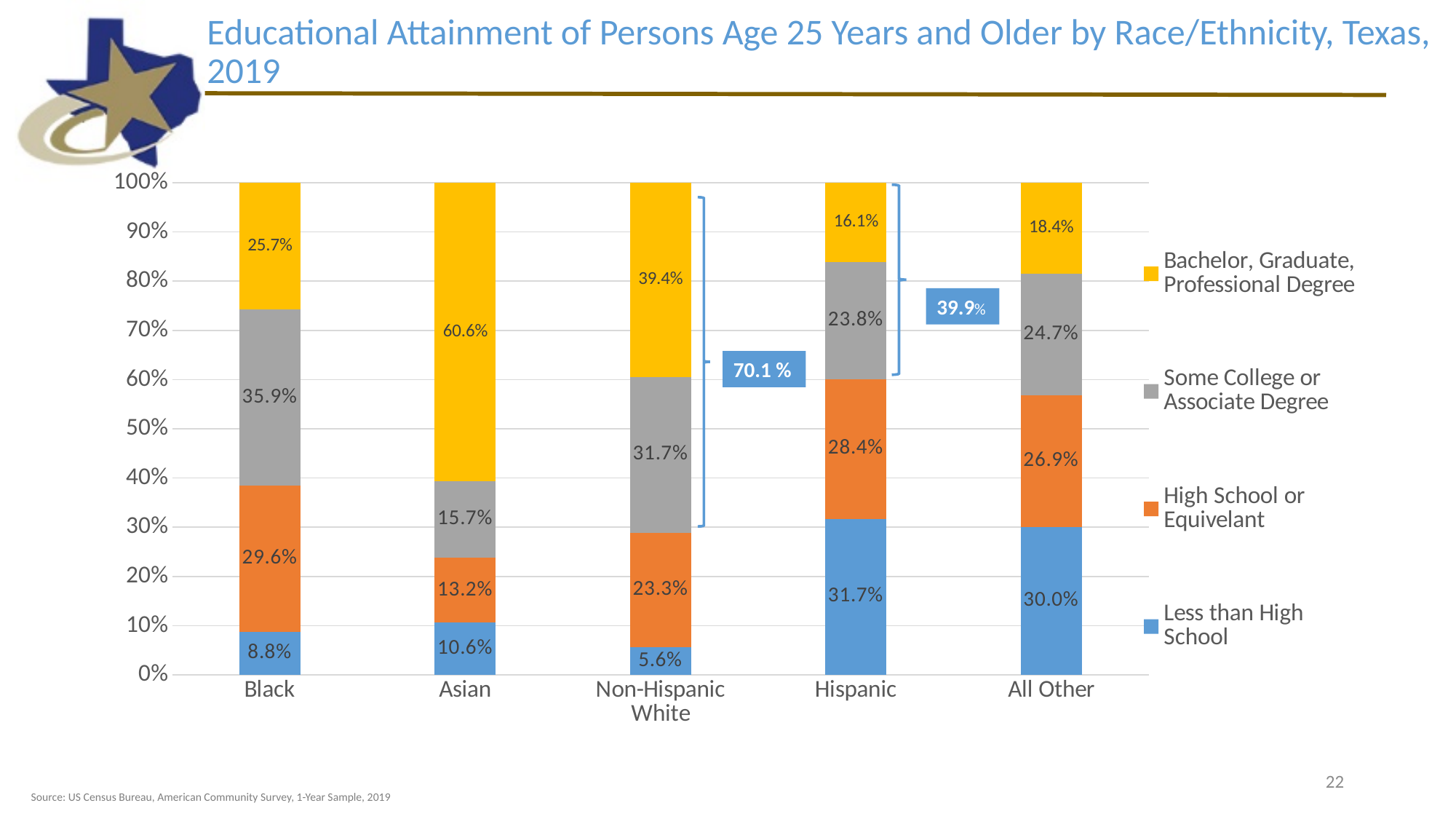
Which is larger: the Some College or Associate Degree share for Black persons or for Asian persons? Black Which colour represents Less than High School in the chart? Blue What is the Some College or Associate Degree value for All Other? 24.7% What kind of chart is shown on the slide? Stacked bar chart How many series does the legend list? 4 What is the difference between the Bachelor, Graduate, Professional Degree shares for Non-Hispanic White and Hispanic persons? 23.3% What is the High School or Equivelant value for Black persons? 29.6% Which race/ethnicity group has the highest share with a Bachelor, Graduate, or Professional Degree? Asian Which race/ethnicity group has the lowest Less than High School share? Non-Hispanic White What percentage of Asian persons have a Bachelor, Graduate, or Professional Degree? 60.6% How many race/ethnicity categories are shown on the x axis? 5 What is the Less than High School share for Hispanic persons? 31.7%